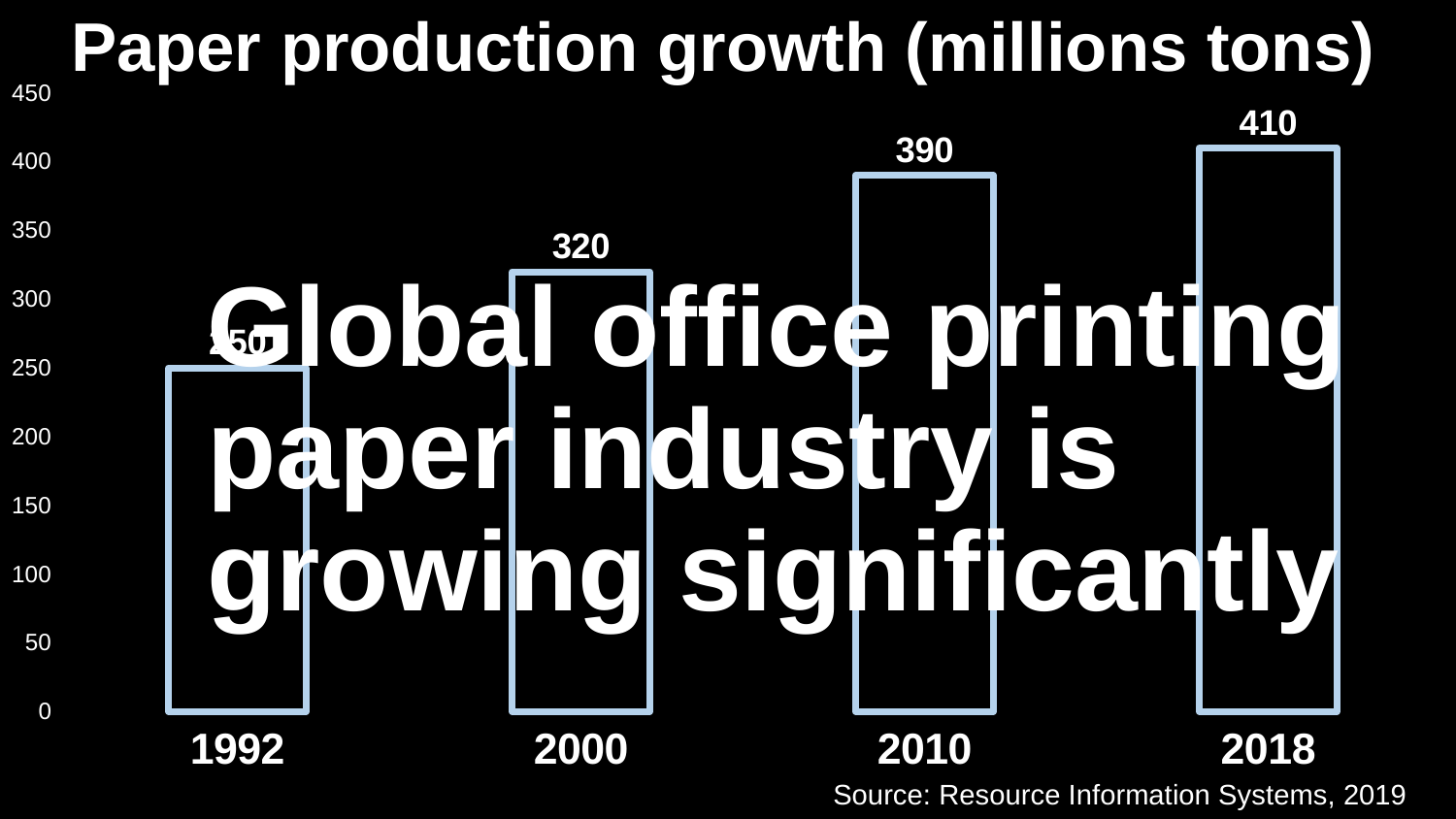
Which year has the lowest value? 1992 What is the difference between the values for 2010 and 2000? 70 Do the values rise or fall from 1992 to 2018? rise What kind of chart is shown on the slide? bar chart Which is larger, the value for 2010 or the value for 2000? 2010 What is the value for 2000? 320 Is the value for 1992 greater or less than 300? less How many years are shown on the x axis? 4 Which year has the highest value? 2018 What is the value for 2010? 390 What is the value for 2018? 410 What is the difference between the values for 2018 and 2000? 90